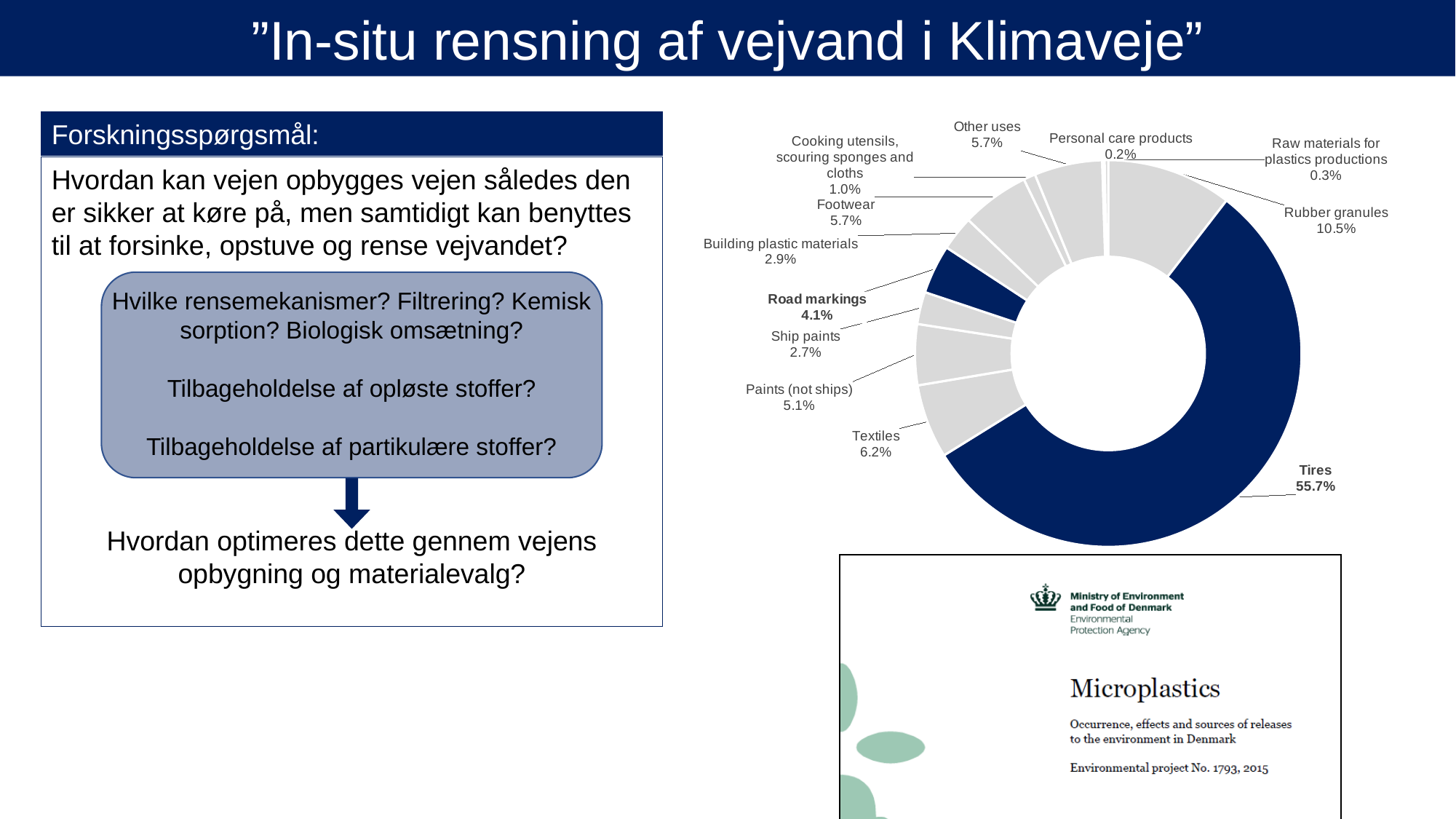
How many categories are shown in the pie chart? 12 What is the difference in percentage points between Tires and Rubber granules in the pie chart? 45.2 Which is larger in the pie chart, Textiles or Paints (not ships)? Textiles What share of the pie chart does Tires account for? 55.7% What is the value shown for Textiles in the pie chart? 6.2% What is the value shown for Personal care products in the pie chart? 0.2% What is the value shown for Road markings in the pie chart? 4.1% What is the value shown for Rubber granules in the pie chart? 10.5% Which category has the smallest slice in the pie chart? Personal care products What kind of chart is shown on the right of the slide? doughnut (pie) chart Which categories are highlighted in dark blue in the pie chart? Tires, Rubber granules, Road markings Which category has the largest slice in the pie chart? Tires